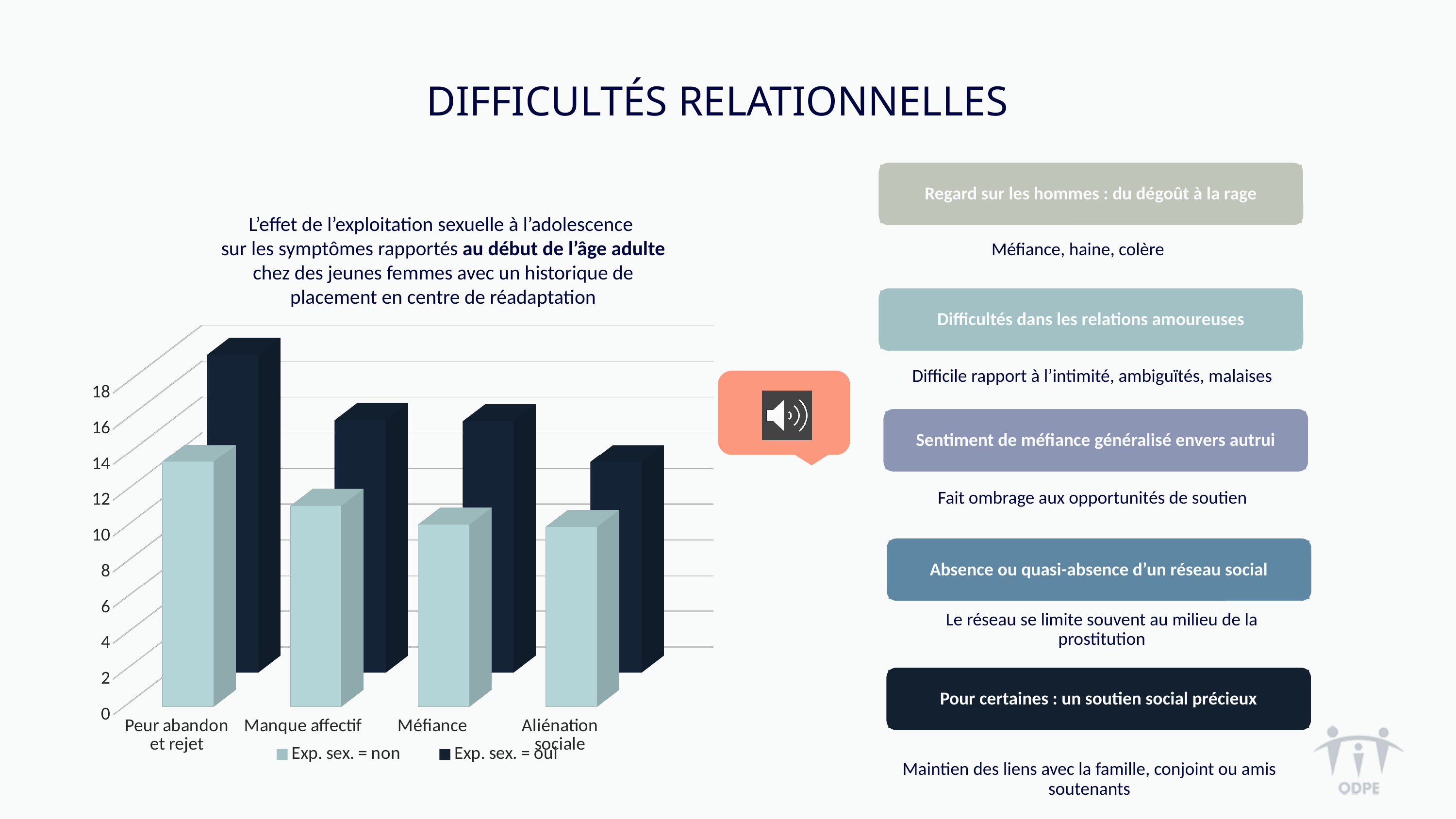
Which category has the highest value for the series "Exp. sex. = oui"? Peur abandon et rejet Which category has the lowest value for the series "Exp. sex. = oui"? Aliénation sociale How many categories are shown on the x axis of the chart? 4 How many series does the chart legend list? 2 Which category has the highest value for the series "Exp. sex. = non"? Peur abandon et rejet Which series is shown in light blue in the chart legend? Exp. sex. = non Is the value for "Exp. sex. = oui" in "Peur abandon et rejet" greater or less than 16? greater What kind of chart is shown on the slide? bar chart For "Peur abandon et rejet", which series has the larger value, "Exp. sex. = non" or "Exp. sex. = oui"? Exp. sex. = oui Is the value for "Exp. sex. = non" in "Aliénation sociale" greater or less than 14? less Is the value for "Exp. sex. = oui" in "Manque affectif" greater or less than 12? greater Which series is shown in dark navy in the chart legend? Exp. sex. = oui